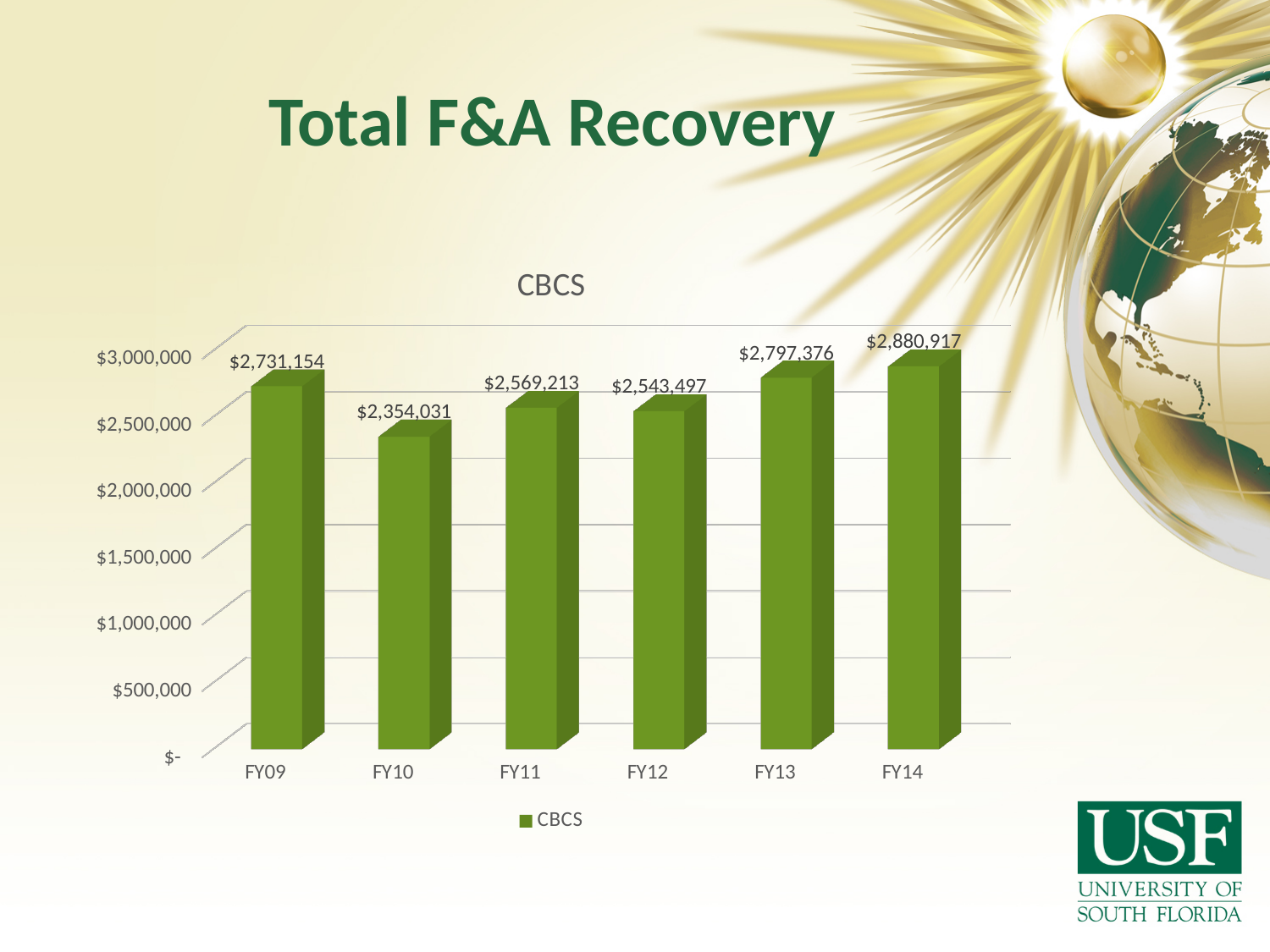
What is the difference between the FY09 and FY10 values? $377,123 What is the difference between the FY14 and FY13 values? $83,541 Which is larger, the value for FY11 or the value for FY12? FY11 Which fiscal year has the lowest CBCS value? FY10 Is the value for FY10 greater or less than $2,500,000? less What is the CBCS value for FY09? $2,731,154 What is the CBCS value for FY14? $2,880,917 How many series does the legend list? 1 How many fiscal years are shown on the x axis? 6 Which fiscal year has the highest CBCS value? FY14 What is the CBCS value for FY12? $2,543,497 What kind of chart is shown on the slide? bar chart